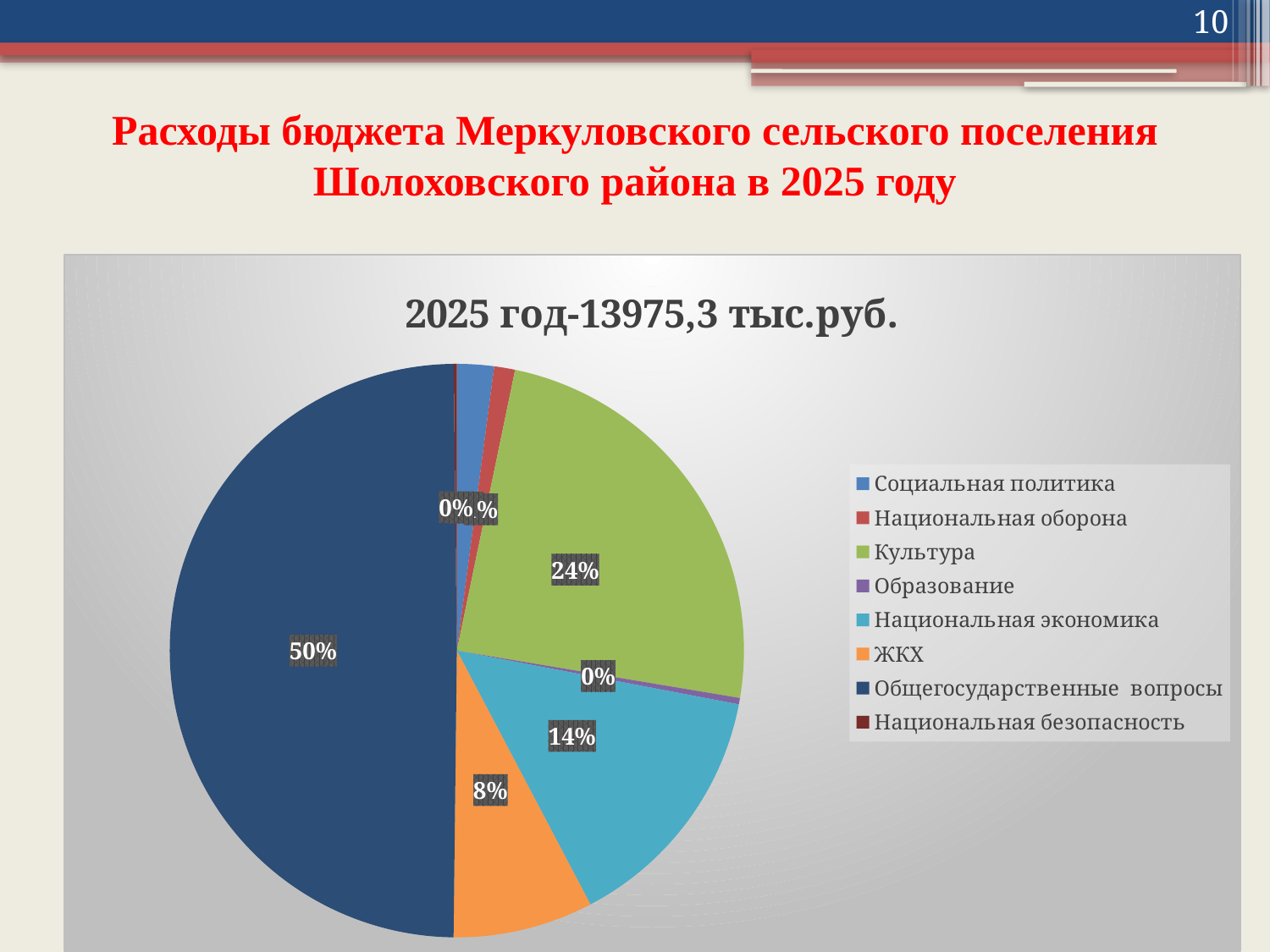
What is the difference between the share for Общегосударственные вопросы and the share for Культура? 26% Which category has the largest slice of the pie? Общегосударственные вопросы What share of the pie is ЖКХ? 8% How many entries does the chart legend list? 8 What share of the pie is Национальная экономика? 14% What share of the pie is Культура? 24% What is the title of the chart? 2025 год-13975,3 тыс.руб. Which is larger, the slice for Культура or the slice for Национальная экономика? Культура What kind of chart is shown on the slide? pie chart What colour is the slice for ЖКХ? orange